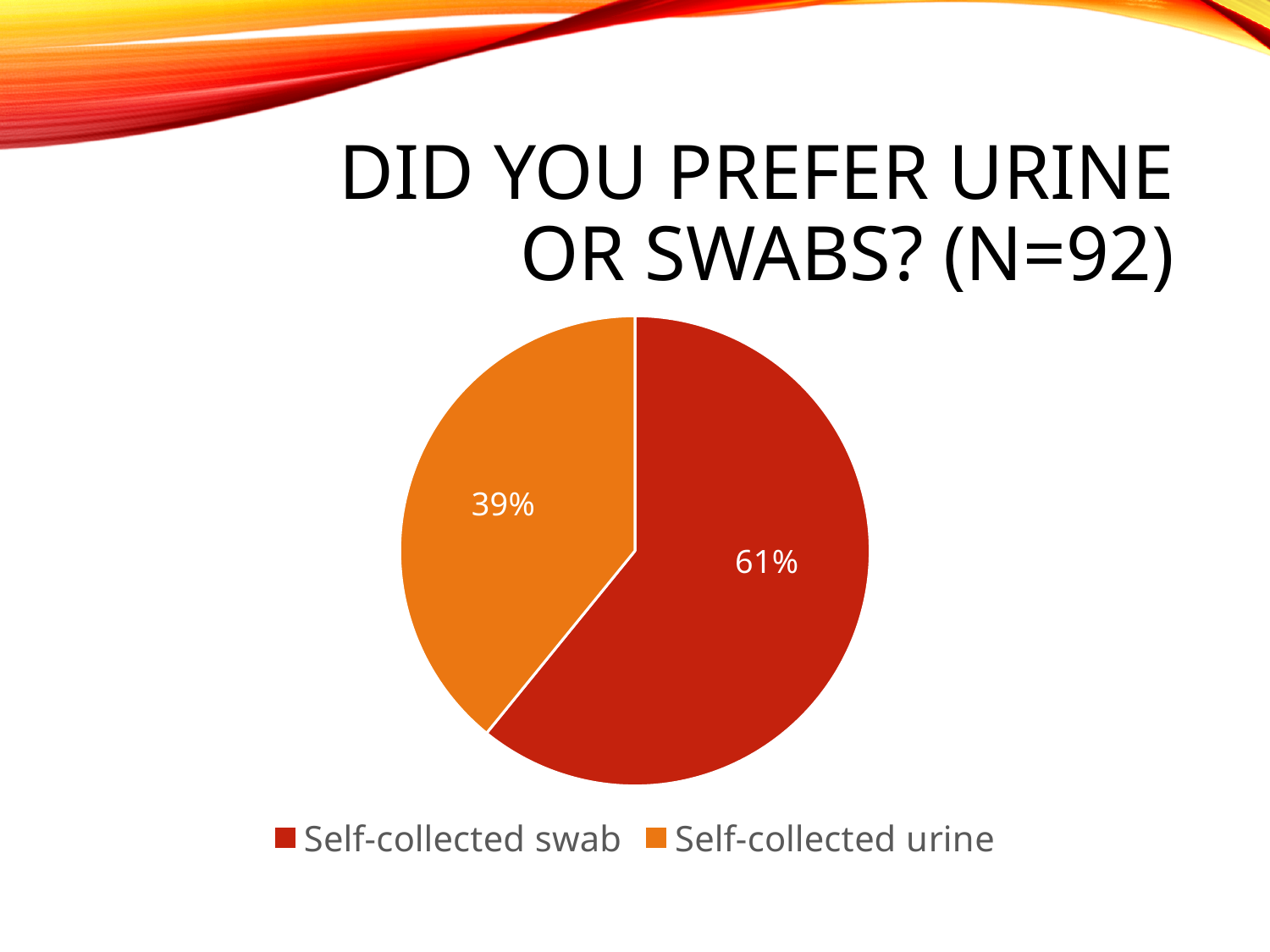
What is the sample size shown in the chart title? 92 What share of the pie is Self-collected urine? 39% Which category has the largest slice of the pie? Self-collected swab What is the difference in percentage points between Self-collected swab and Self-collected urine? 22 How many slices does the pie chart have? 2 What colour is the Self-collected urine slice? Orange What is the title of the chart? Did you prefer urine or swabs? (N=92) Which category has the smallest slice of the pie? Self-collected urine What kind of chart is shown on the slide? Pie chart How many entries does the legend list? 2 What share of the pie is Self-collected swab? 61% Which is larger, the share for Self-collected swab or for Self-collected urine? Self-collected swab